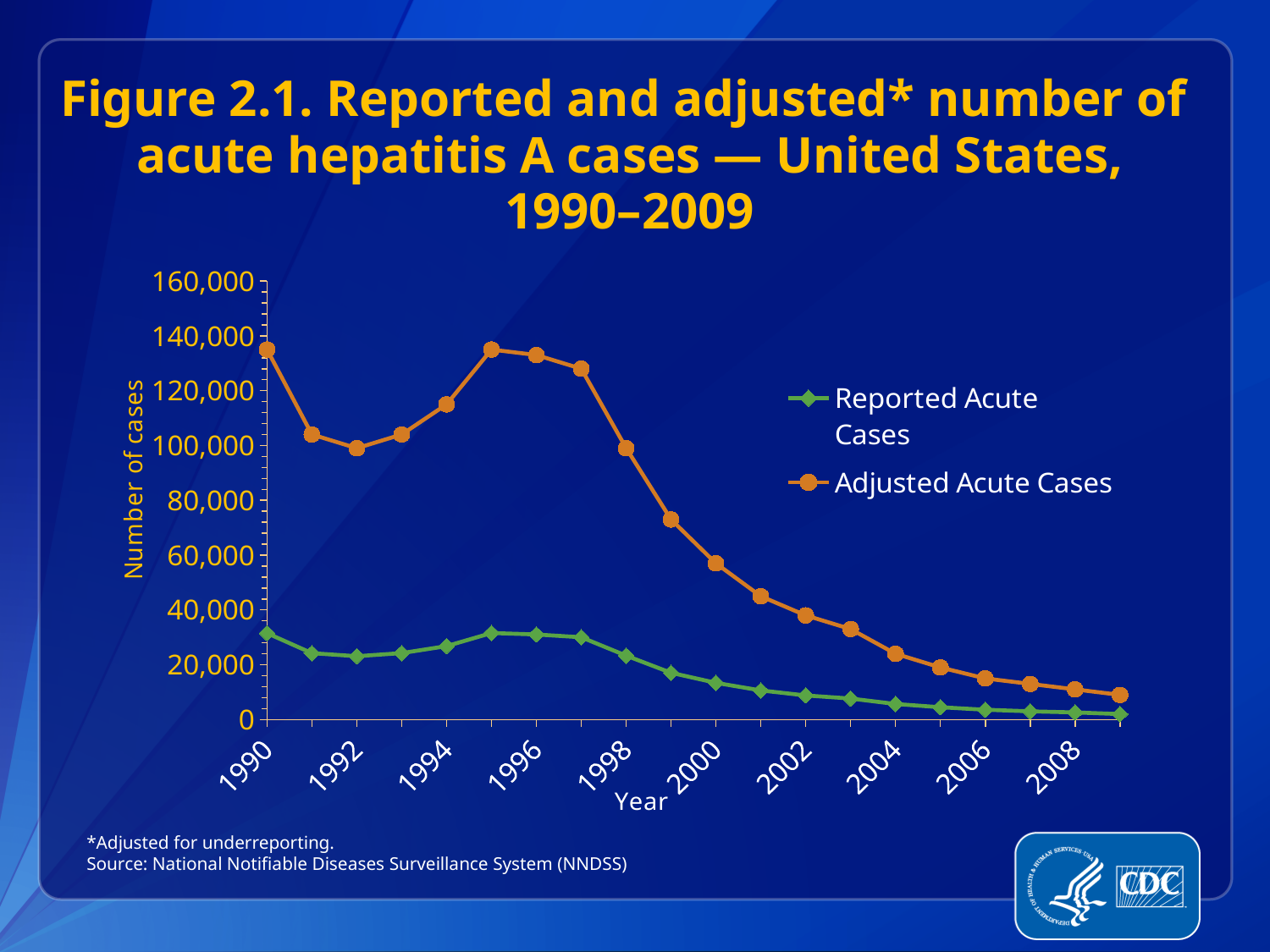
Is the Reported Acute Cases value for 1990 greater or less than 20,000? greater What is the label of the vertical axis? Number of cases How many yearly data points does each series have? 20 Which series has the larger value in 1995, Reported Acute Cases or Adjusted Acute Cases? Adjusted Acute Cases In which year is the Reported Acute Cases value lowest? 2009 Do the Adjusted Acute Cases values rise or fall from 1997 to 2009? Fall Is the Adjusted Acute Cases value for 1990 greater or less than 120,000? greater Is the Adjusted Acute Cases value for 2000 greater or less than 40,000? greater In which year is the Adjusted Acute Cases value lowest? 2009 What kind of chart is shown on the slide? Line chart How many series does the legend list? 2